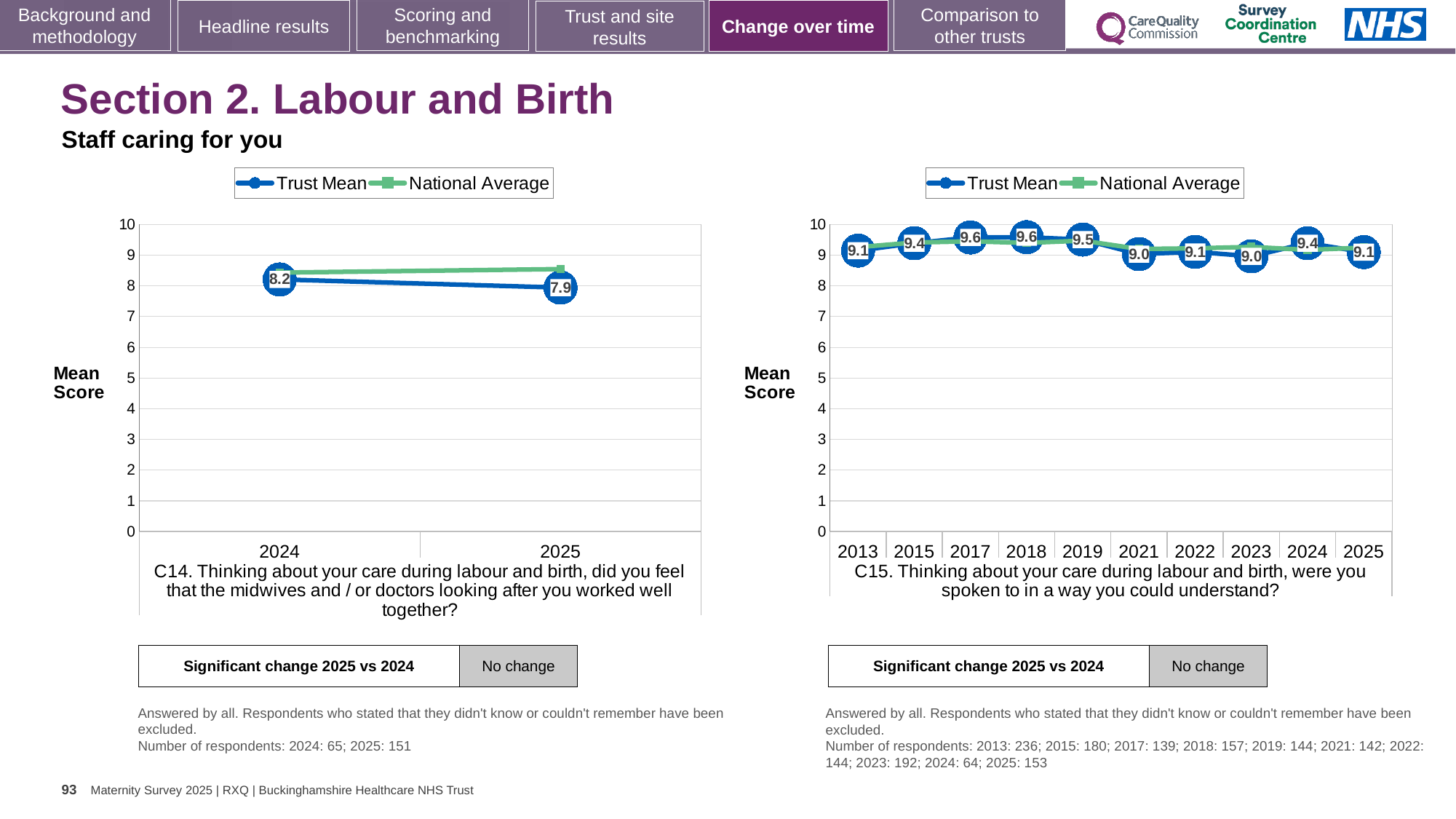
How many series does the legend of the right chart (C15) list? 2 What type of chart is the left chart (C14)? line chart In the right chart (C15), what is the difference between the Trust Mean in 2017 and in 2021? 0.6 In the right chart (C15), how many years are plotted on the x axis? 10 In the left chart (C14), by how much did the Trust Mean change from 2024 to 2025? 0.3 In the left chart (C14), is the National Average for 2025 greater or less than 8? greater In the right chart (C15), what is the Trust Mean for 2025? 9.1 In the left chart (C14), does the Trust Mean rise or fall from 2024 to 2025? fall In the right chart (C15), what is the Trust Mean for 2019? 9.5 In the left chart (C14), what is the Trust Mean for 2024? 8.2 In the right chart (C15), which year has the lowest Trust Mean? 2021 and 2023 (9.0) In the left chart (C14), what is the Trust Mean for 2025? 7.9